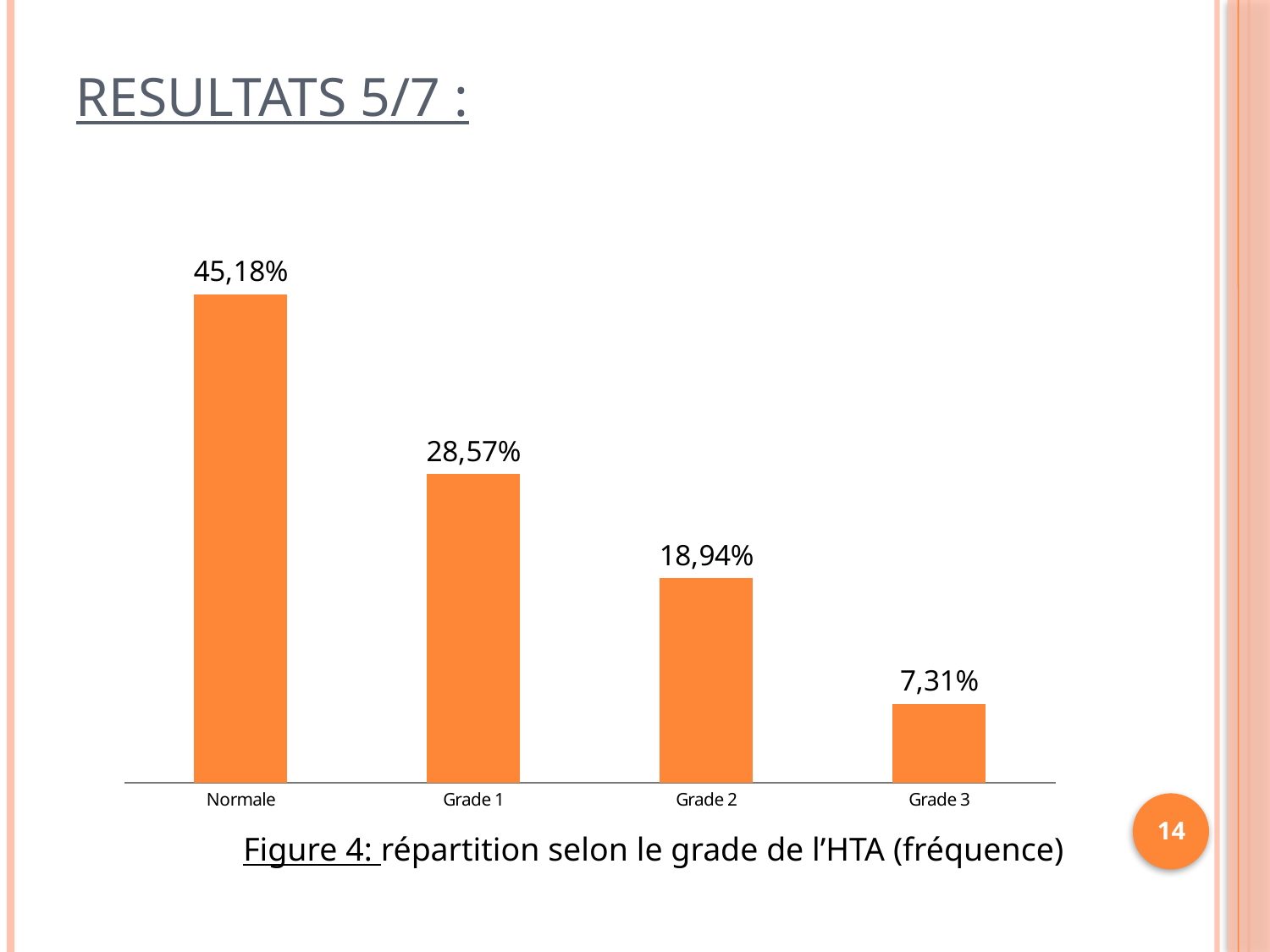
What is the value for Normale? 45,18% What is the value for Grade 1? 28,57% What is the value for Grade 2? 18,94% Which category has the highest value? Normale What is the value for Grade 3? 7,31% What is the difference between the values for Normale and Grade 1? 16,61% What kind of chart is shown on the slide? Bar chart What is the difference between the values for Grade 2 and Grade 3? 11,63% Do the values rise or fall from Normale to Grade 3 along the x axis? Fall Which category has the lowest value? Grade 3 Which is larger, the value for Grade 1 or the value for Grade 2? Grade 1 How many categories are shown on the x axis? 4